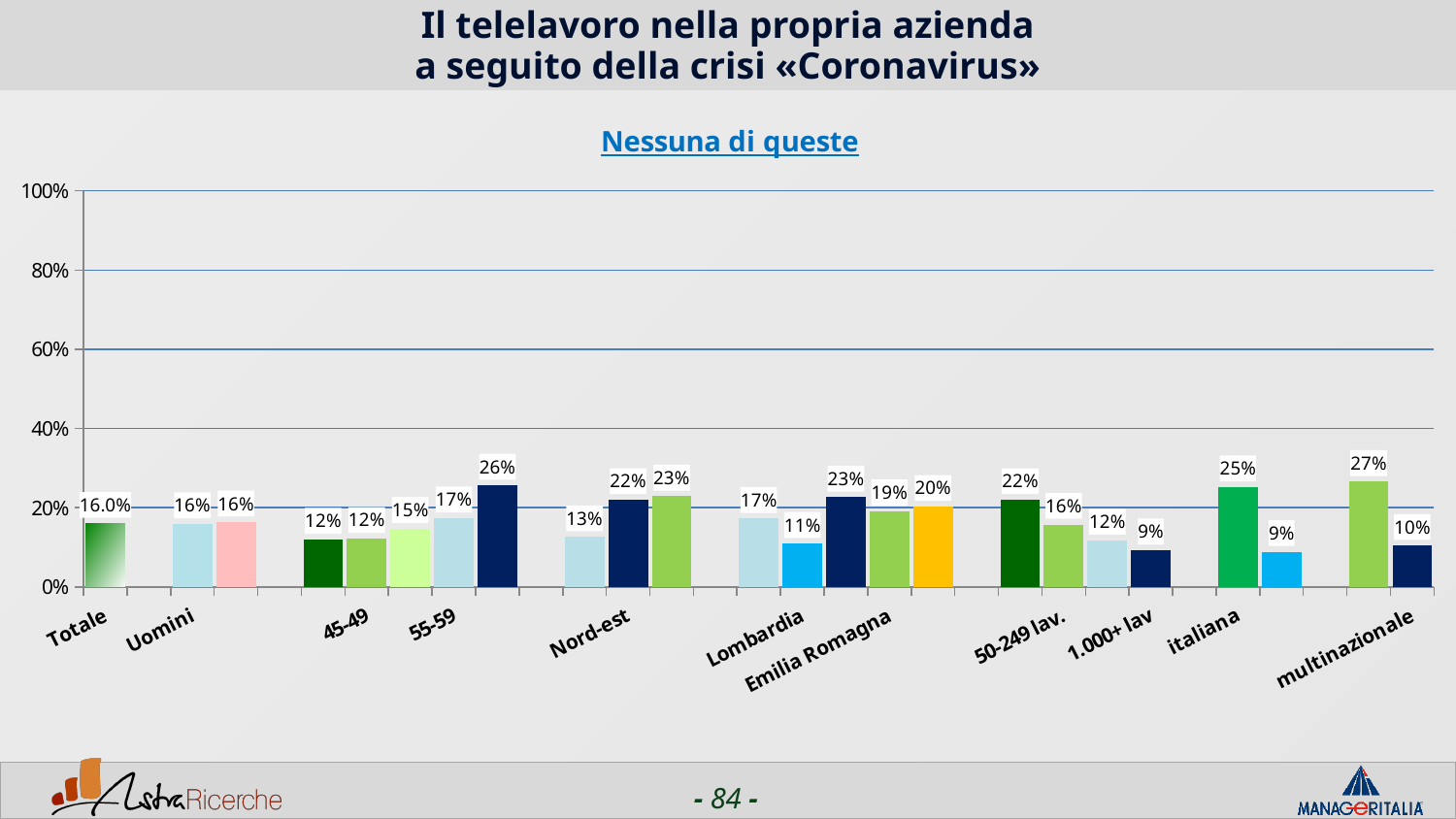
What is the value for Totale? 16.0% What is the difference between the value for italiana and the value for multinazionale? 15% What kind of chart is shown on the slide? bar chart What is the value for 55-59? 17% What is the value for Emilia Romagna? 19% What is the value for Uomini? 16% What is the value for Nord-est? 22% What is the subtitle shown above the chart? Nessuna di queste Which is larger, the value for italiana or the value for multinazionale? italiana What is the value for italiana? 25% What is the value for multinazionale? 10% Is the value for Totale greater or less than 20%? less